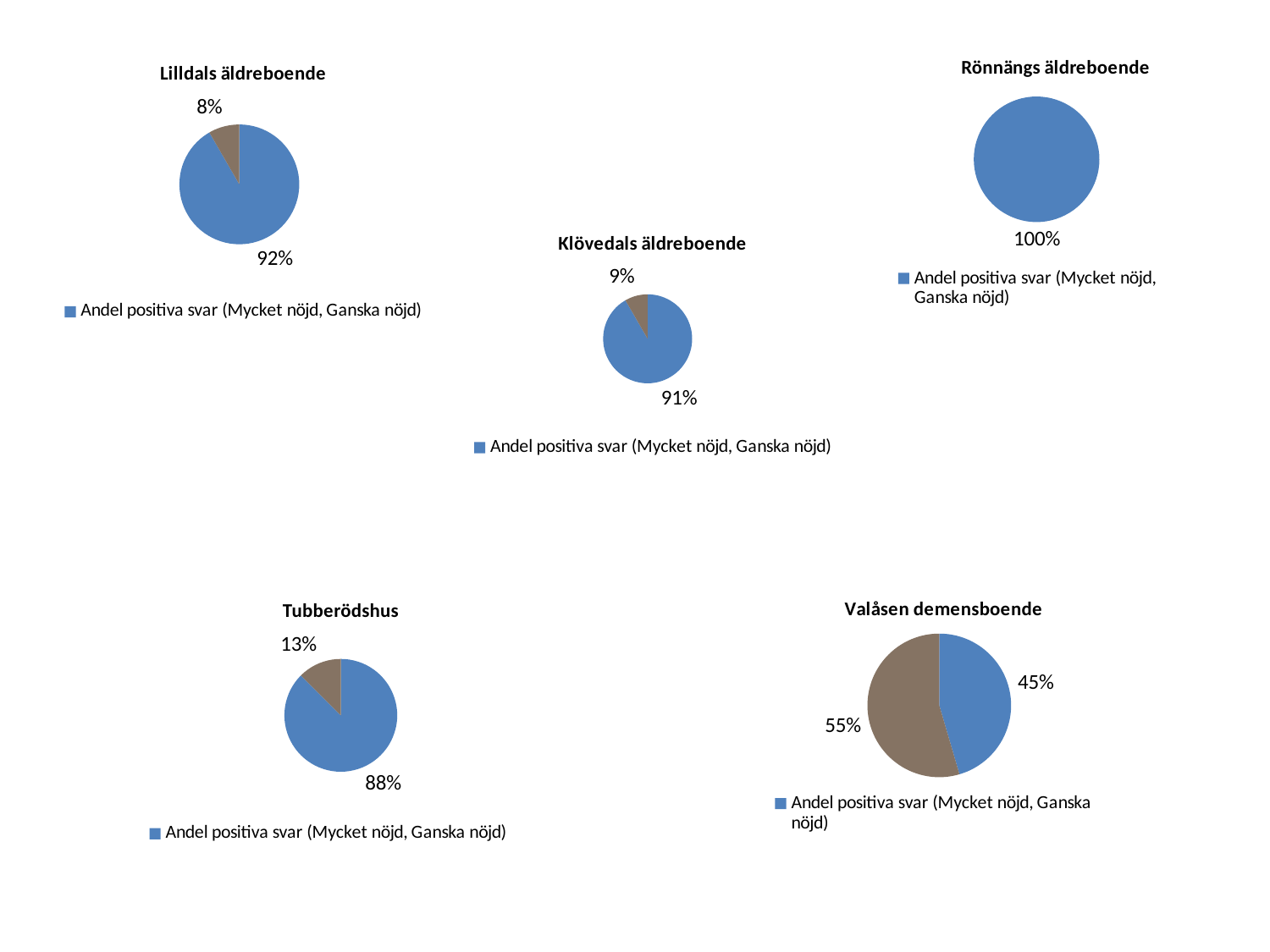
In the Klövedals äldreboende chart, what share of the pie is the blue slice (Andel positiva svar)? 91% In the Klövedals äldreboende chart, what percentage is shown for the brown slice? 9% In the Tubberödshus chart, what share of the pie is the blue slice (Andel positiva svar)? 88% What kind of chart is used for Tubberödshus? Pie chart In the Rönnängs äldreboende chart, what percentage is shown for Andel positiva svar? 100% In the Lilldals äldreboende chart, what share of the pie is the blue slice (Andel positiva svar)? 92% In the Lilldals äldreboende chart, what percentage is shown for the brown slice? 8% Which chart on the slide shows the lowest share of Andel positiva svar? Valåsen demensboende Which chart on the slide shows the highest share of Andel positiva svar? Rönnängs äldreboende In the Tubberödshus chart, what percentage is shown for the brown slice? 13% In the Valåsen demensboende chart, what percentage is shown for the blue slice (Andel positiva svar)? 45% In the Valåsen demensboende chart, what percentage is shown for the brown slice? 55%